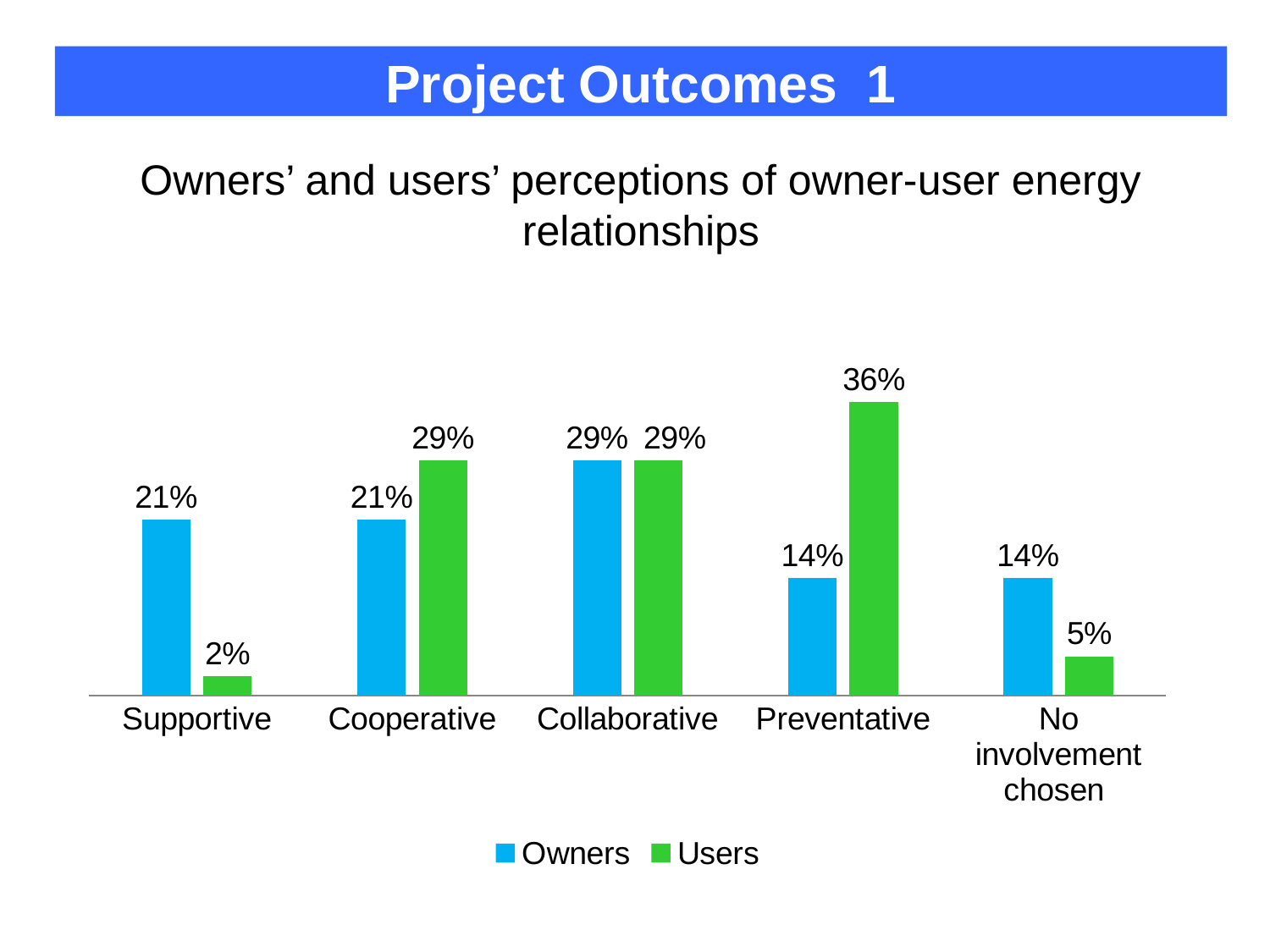
What kind of chart is shown on the slide? Bar chart Which is larger for Cooperative, the Owners value or the Users value? Users How many series does the legend list? 2 Which category has the highest Users value? Preventative What is the Users value for No involvement chosen? 5% What is the Owners value for Supportive? 21% How many categories are shown on the x axis? 5 Which series is shown in green in the legend? Users Which category has the lowest Users value? Supportive What is the difference between the Users and Owners values for Preventative? 22% What is the difference between the Owners and Users values for Supportive? 19% What is the Users value for Preventative? 36%